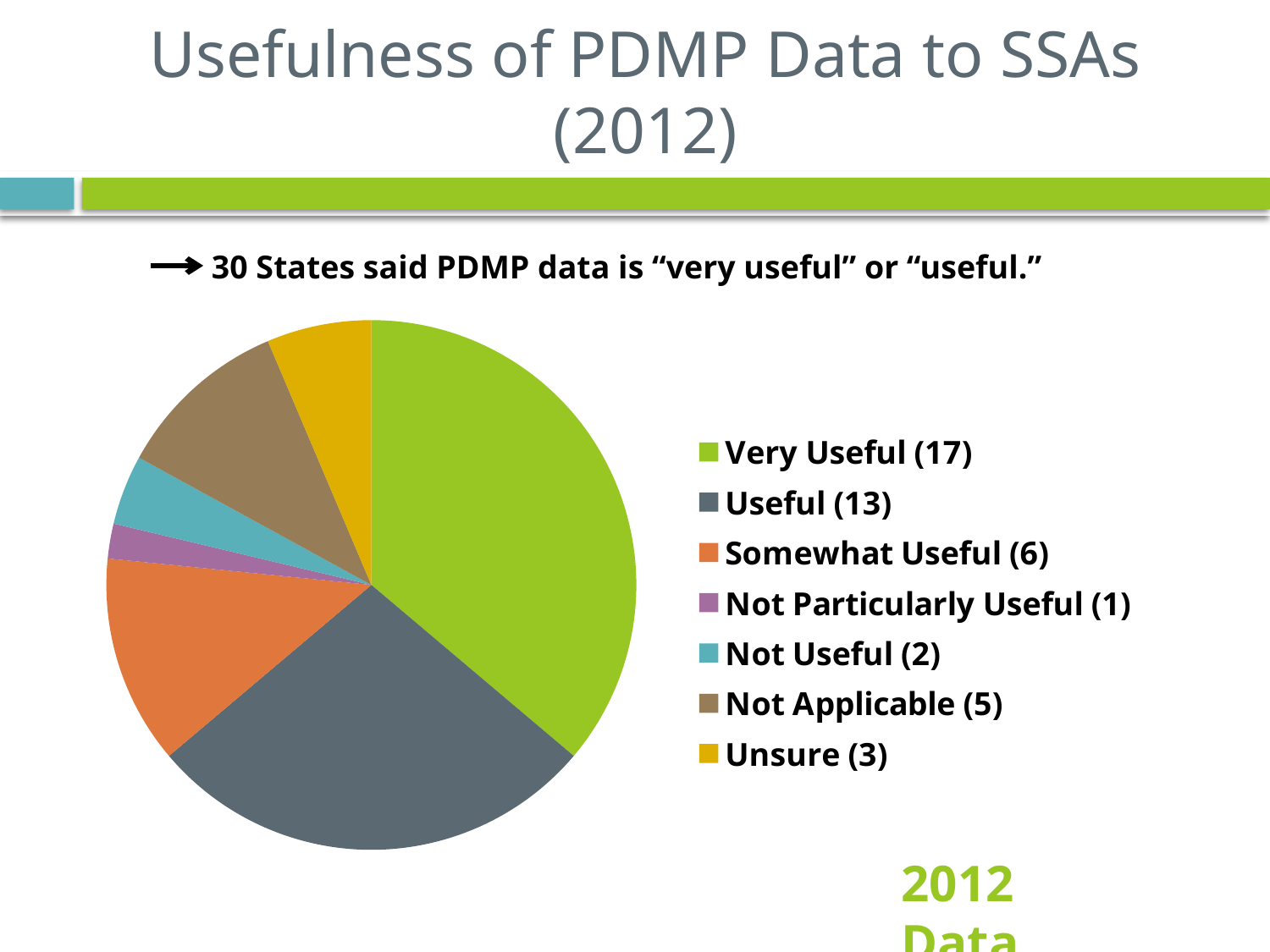
How many states rated PDMP data as "Somewhat Useful"? 6 What colour is the "Unsure" slice of the pie? yellow Which is larger: the number of states that said "Not Useful" or the number that said "Unsure"? Unsure What is the total number of states represented in the pie chart? 47 How many states answered "Not Applicable"? 5 What kind of chart is shown on the slide? pie chart What is the difference between the number of states that said "Very Useful" and the number that said "Useful"? 4 Which category has the largest slice of the pie? Very Useful Which category has the smallest slice of the pie? Not Particularly Useful How many states rated PDMP data as "Very Useful"? 17 How many categories does the pie chart have? 7 How many states rated PDMP data as "Useful"? 13